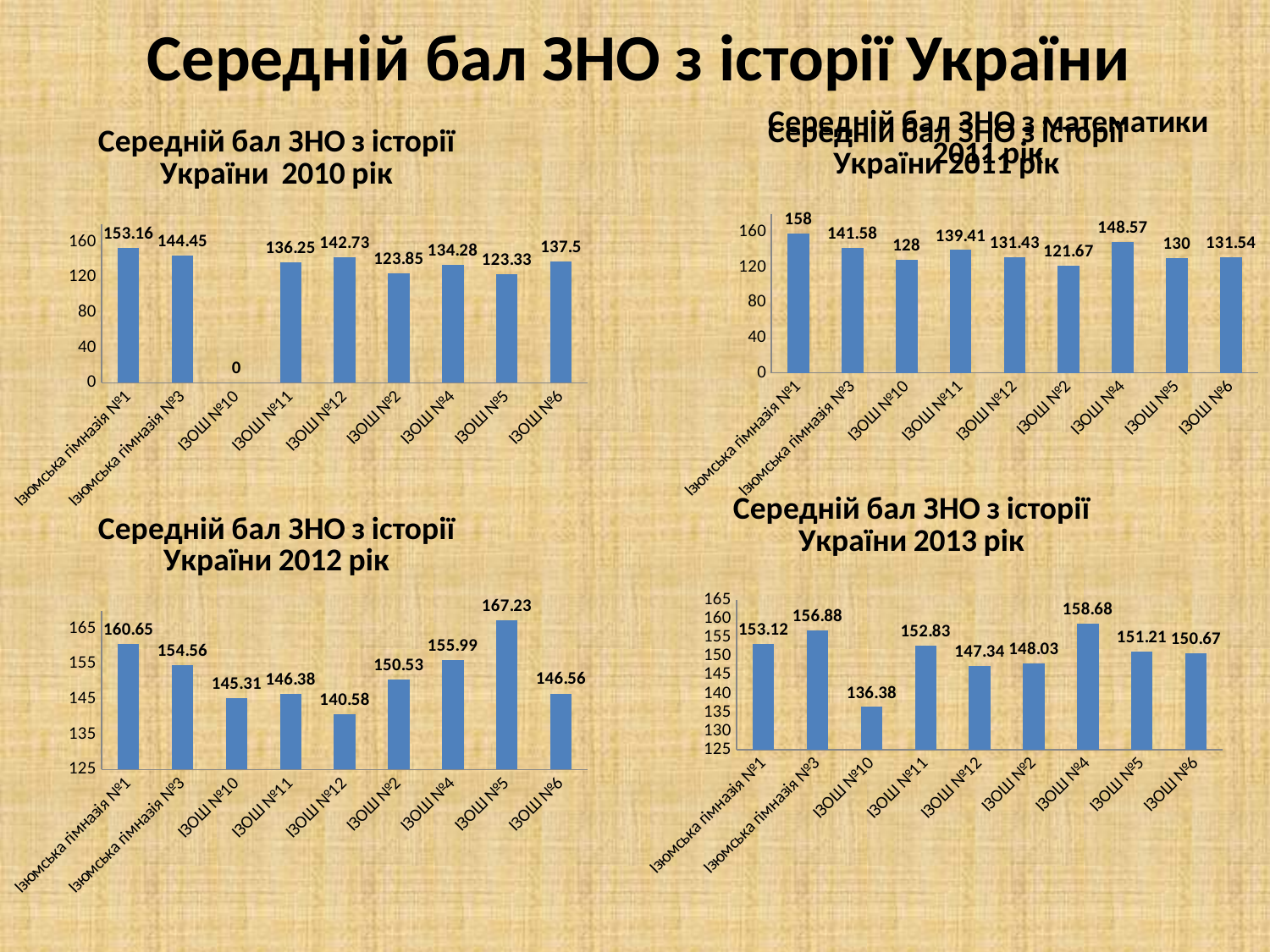
In the bottom-right chart (2013), which category has the lowest value? ІЗОШ №10 In the top-left chart (2010), what is the value for ІЗОШ №10? 0 In the bottom-left chart (2012), what is the difference between the values for ІЗОШ №5 and ІЗОШ №12? 26.65 In the bottom-right chart (2013), which is larger: the value for Ізюмська гімназія №3 or the value for ІЗОШ №4? ІЗОШ №4 What type of chart is the bottom-left chart (2012)? Bar chart In the top-right chart (2011), which category has the highest value? Ізюмська гімназія №1 In the top-right chart (2011), what is the value for ІЗОШ №4? 148.57 In the top-left chart (2010), what is the value for Ізюмська гімназія №1? 153.16 In the bottom-left chart (2012), which category has the highest value? ІЗОШ №5 How many categories are shown in the bottom-right chart (2013)? 9 How many charts are shown on the slide? 4 In the top-right chart (2011), which category has the lowest value? ІЗОШ №2